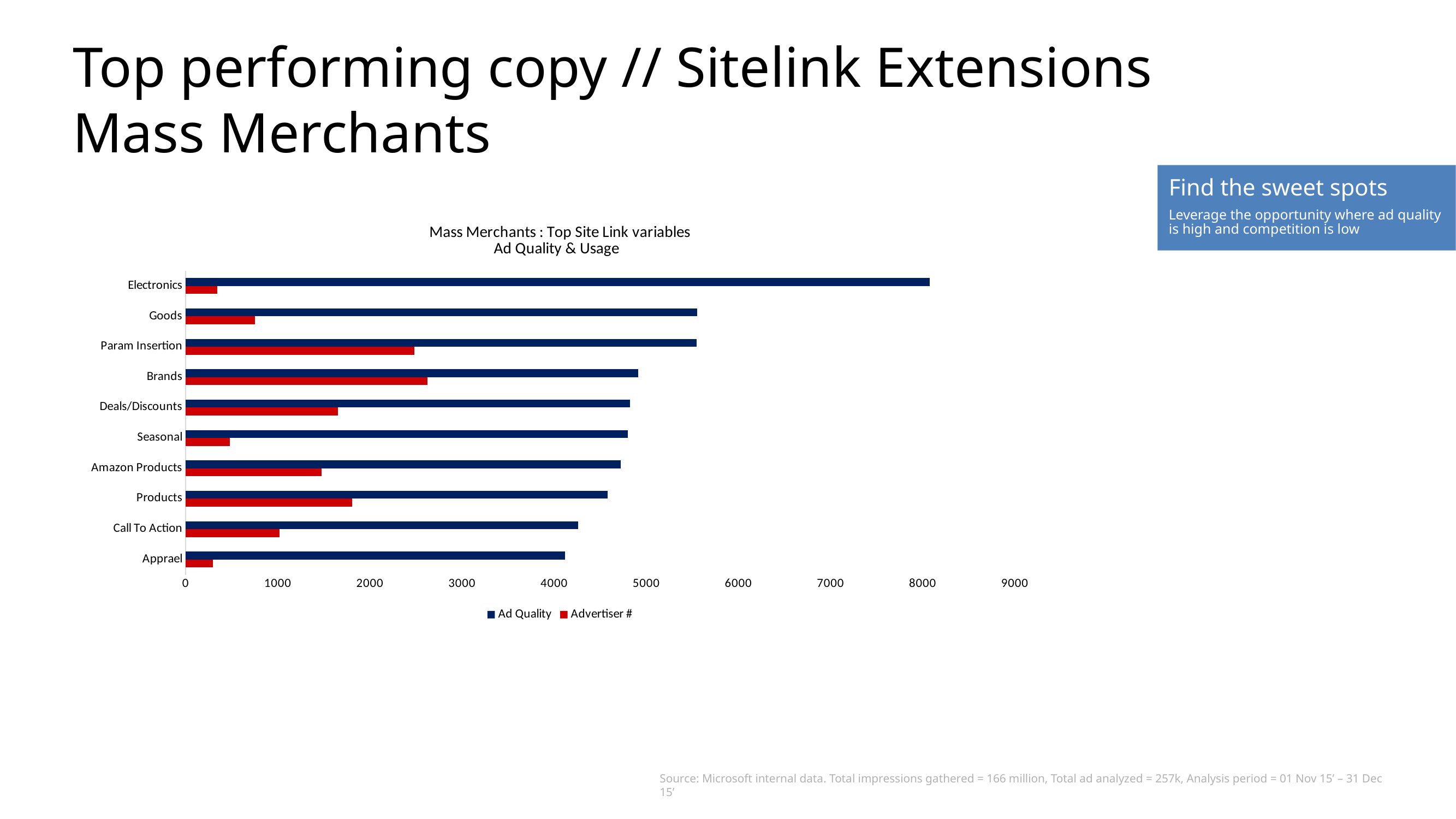
How many categories are plotted on the chart? 10 Is the Advertiser # value for Products greater or less than 2000? less Is the Advertiser # value for Goods greater or less than 1000? less Is the Advertiser # value for Param Insertion greater or less than 2000? greater How many series does the legend list? 2 Which has a larger Ad Quality value, Electronics or Goods? Electronics What is the title of the chart? Mass Merchants : Top Site Link variables Ad Quality & Usage Which category has the highest Ad Quality value? Electronics Which has a larger Advertiser # value, Brands or Seasonal? Brands What kind of chart is shown on the slide? Bar chart